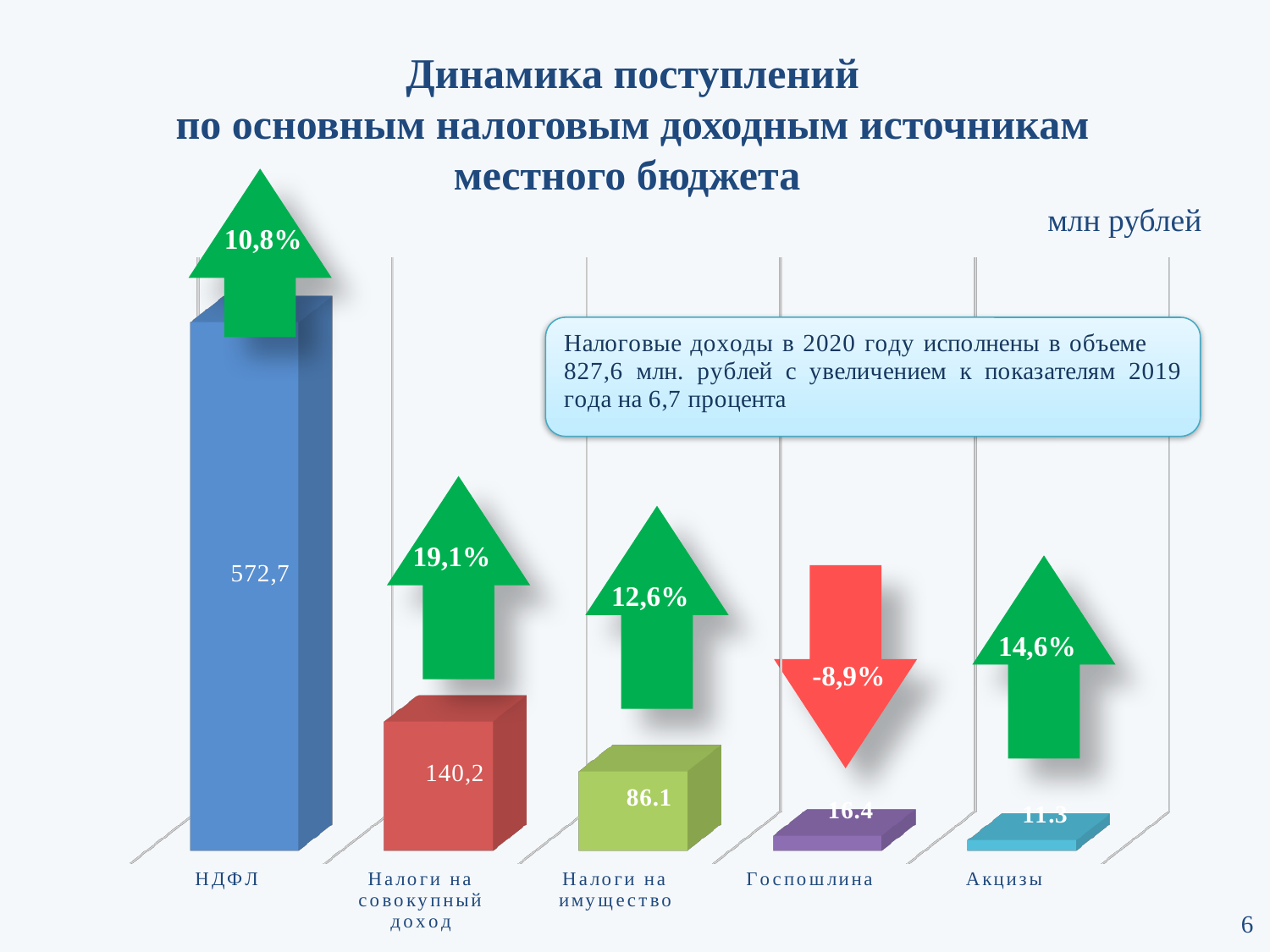
What unit of measurement is indicated for the chart? млн рублей What is the value for Налоги на совокупный доход? 140,2 What is the value for НДФЛ? 572,7 What kind of chart is shown on the slide? Bar chart Which is larger, the value for Налоги на имущество or the value for Госпошлина? Налоги на имущество Which category has the highest value? НДФЛ How many categories are shown in the chart? 5 Which category is marked with a red downward arrow indicating a decrease? Госпошлина Do the bar values rise or fall from left to right along the x axis? Fall What is the value for Налоги на имущество? 86.1 What is the difference between the values for НДФЛ and Налоги на совокупный доход? 432,5 What is the difference between the values for Налоги на совокупный доход and Налоги на имущество? 54,1